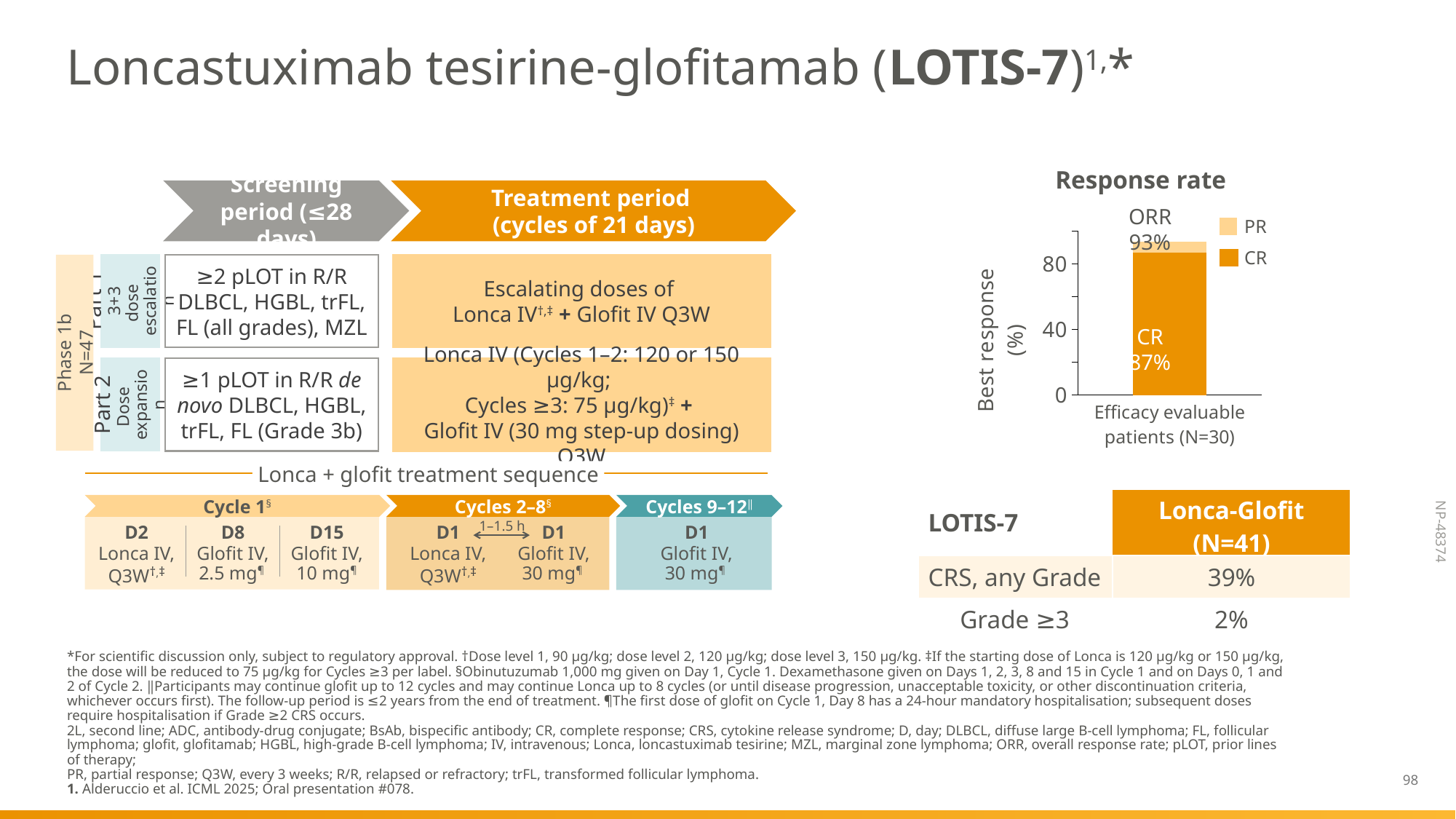
In the Response rate chart, is the CR value greater or less than 80? greater In the Response rate chart, what is the total height of the stacked bar (ORR)? 93% In the Response rate chart, what is the ORR for efficacy evaluable patients (N=30)? 93% In the Response rate chart, is the ORR greater or less than 40? greater What is the y-axis label of the Response rate chart? Best response (%) How many series does the legend of the Response rate chart list? 2 What is the title of the chart on the right of the slide? Response rate What kind of chart is the Response rate chart? bar chart In the Response rate chart, what is the CR value for efficacy evaluable patients? 87% In the Response rate chart, what is the difference between the ORR and the CR rate? 6% How many categories are plotted on the x axis of the Response rate chart? 1